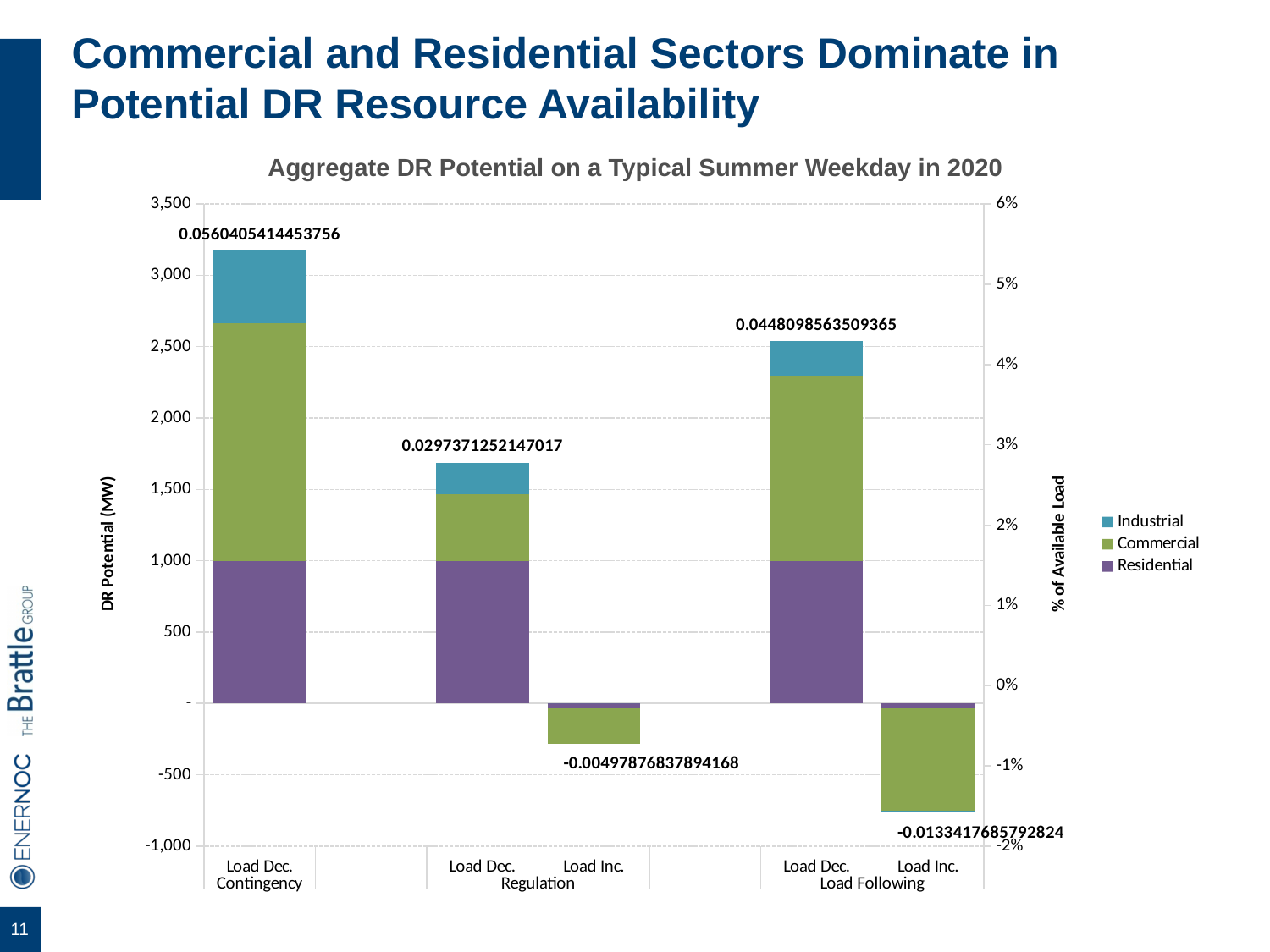
How many series does the legend list? 3 What data label is printed for the Load Inc. Load Following bar? -0.0133417685792824 What data label is printed above the Load Dec. Contingency bar? 0.0560405414453756 Which is larger in total DR potential: Load Dec. Regulation or Load Dec. Load Following? Load Dec. Load Following Which bar has the highest total DR potential? Load Dec. Contingency How many bars are plotted in the chart? 5 What data label is printed for the Load Inc. Regulation bar? -0.00497876837894168 What is the title of the chart? Aggregate DR Potential on a Typical Summer Weekday in 2020 Is the total DR potential for Load Dec. Contingency greater or less than 3,000 MW? greater What data label is printed above the Load Dec. Regulation bar? 0.0297371252147017 What kind of chart is shown on the slide? Stacked bar chart Which bar has the lowest (most negative) total DR potential? Load Inc. Load Following